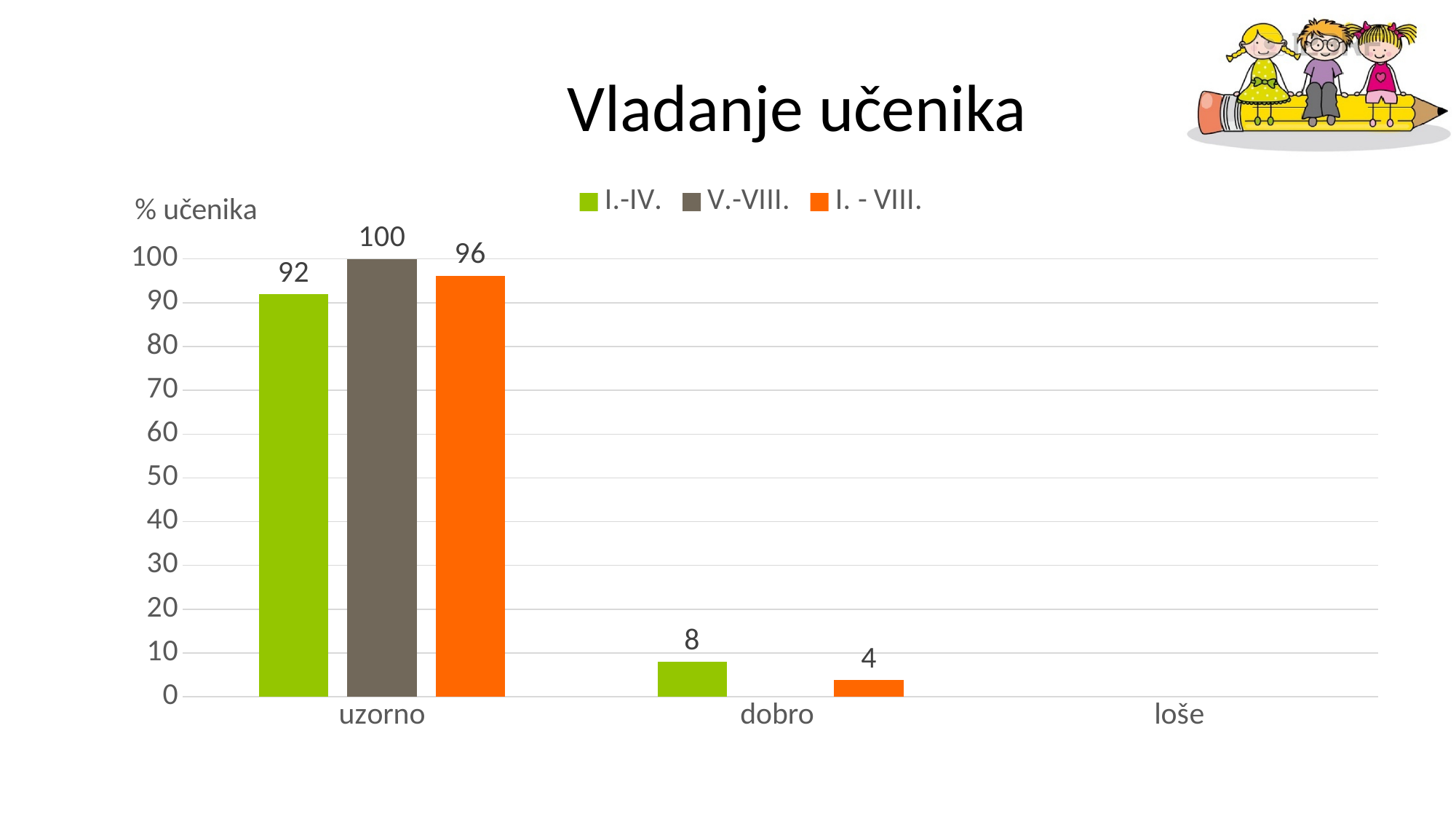
Which series has the highest value in the uzorno category? V.-VIII. Which is larger in the uzorno category: the I.-IV. value or the I. - VIII. value? I. - VIII. How many categories are shown on the x axis? 3 What is the value for I. - VIII. in the dobro category? 4 What is the difference between the V.-VIII. and I.-IV. values in the uzorno category? 8 What kind of chart is shown on the slide? Bar chart What is the value for I.-IV. in the dobro category? 8 What is the difference between the I.-IV. and I. - VIII. values in the dobro category? 4 What is the value for I.-IV. in the uzorno category? 92 What is the value for V.-VIII. in the uzorno category? 100 What is the value for I. - VIII. in the uzorno category? 96 How many series does the legend list? 3